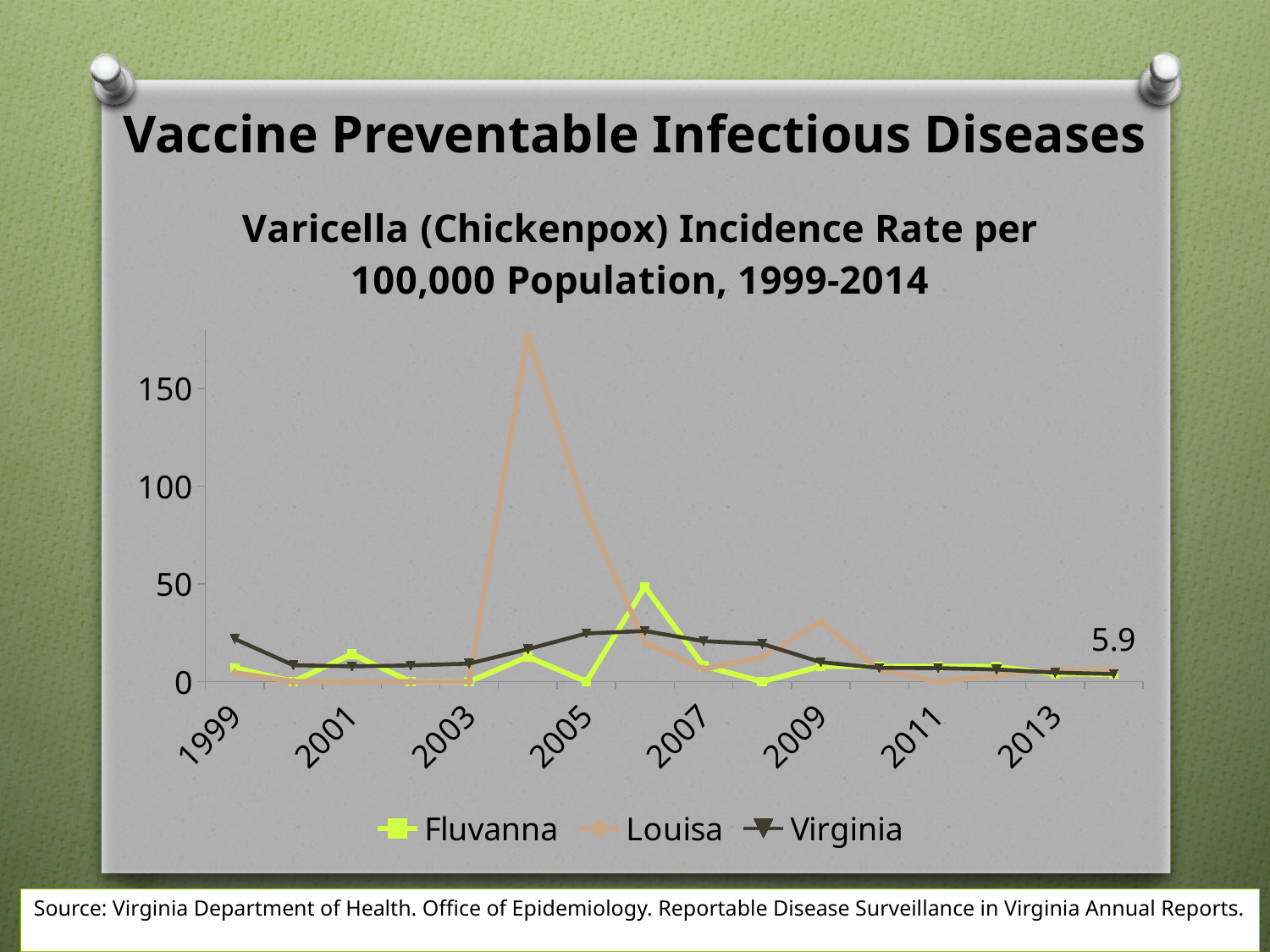
Which series are listed in the legend? Fluvanna, Louisa, Virginia What data label is printed at the end of the lines in 2014? 5.9 In 2006, which is larger, the value for Fluvanna or the value for Virginia? Fluvanna What is the title of the chart? Varicella (Chickenpox) Incidence Rate per 100,000 Population, 1999-2014 How many years are plotted along the x axis? 16 Is the value for Louisa in 2004 greater or less than 150? greater Which series reaches the highest value on the chart? Louisa In 2004, which is larger, the value for Louisa or the value for Virginia? Louisa What kind of chart is shown on the slide? line chart How many series does the legend list? 3 In which year does Louisa reach its peak? 2004 Is the value for Virginia in 1999 greater or less than 50? less